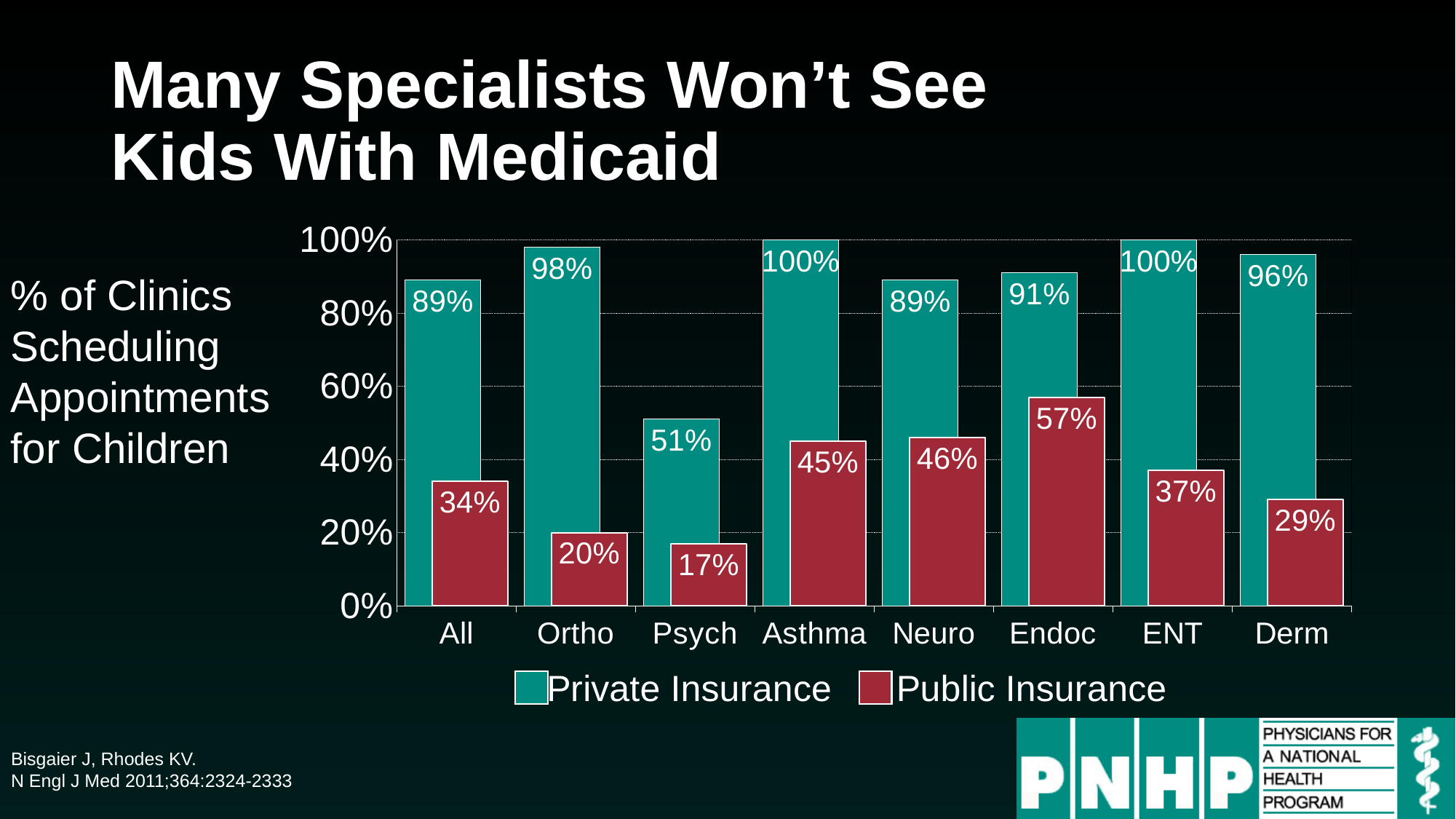
What is the Public Insurance value for Derm? 29% What is the Public Insurance value for Endoc? 57% What is the Private Insurance value for Psych? 51% How many categories are shown on the x axis? 8 What colour are the Public Insurance bars? Red Which category has the highest Public Insurance value? Endoc Which category has the lowest Public Insurance value? Psych What kind of chart is shown on the slide? Bar chart How many series does the legend list? 2 Which category has the lowest Private Insurance value? Psych What is the difference between the Private Insurance and Public Insurance values for Ortho? 78% Which is larger for ENT: the Private Insurance value or the Public Insurance value? Private Insurance